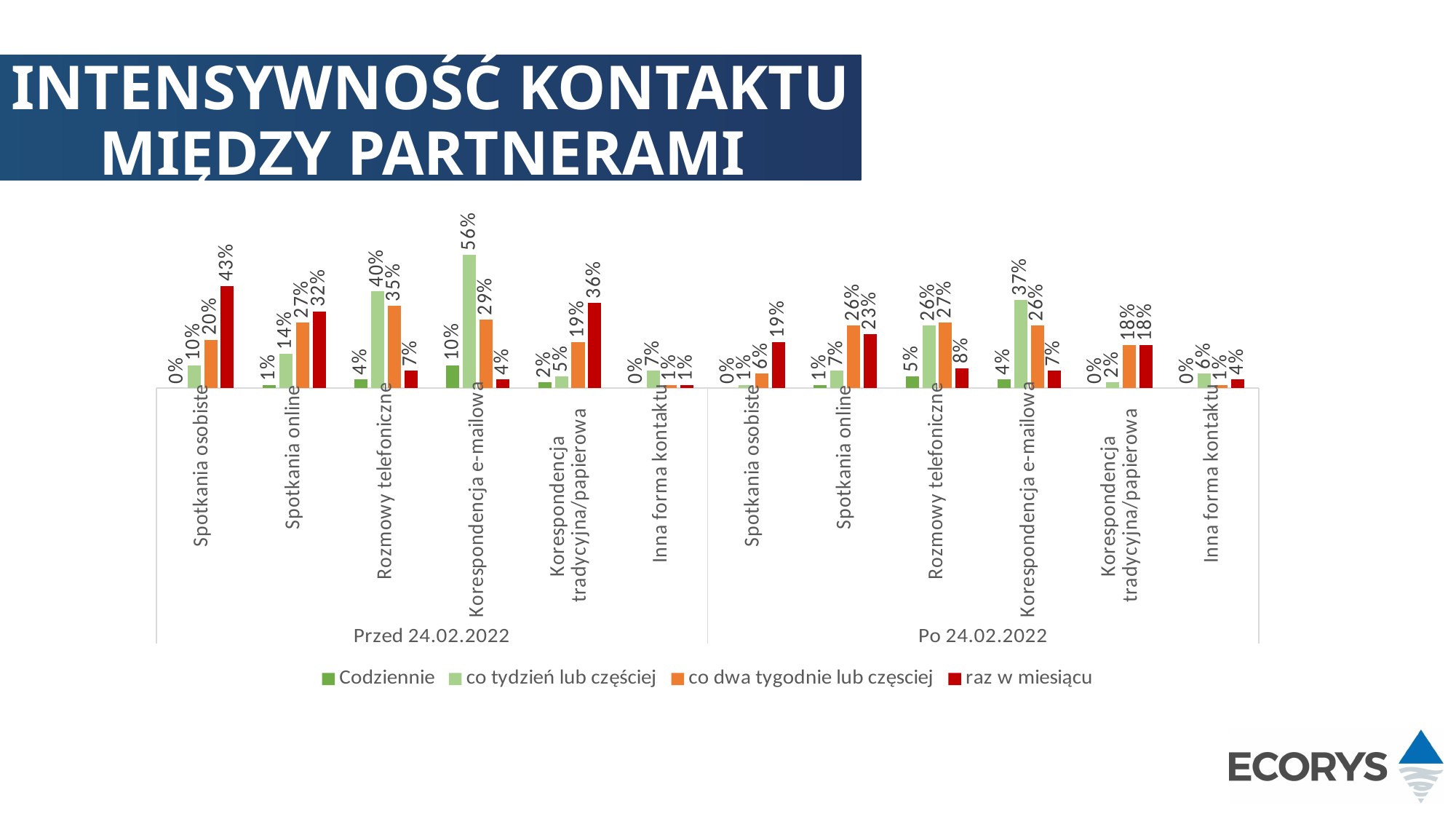
Which is larger: the 'raz w miesiącu' value for 'Spotkania osobiste' in the 'Przed 24.02.2022' group or in the 'Po 24.02.2022' group? Przed 24.02.2022 How many categories are shown in the 'Po 24.02.2022' group? 6 Which category has the lowest 'raz w miesiącu' value in the 'Po 24.02.2022' group? Inna forma kontaktu What is the value for 'co dwa tygodnie lub częsciej' for 'Rozmowy telefoniczne' in the 'Przed 24.02.2022' group? 35% What kind of chart is shown on the slide? bar chart What is the title of the slide? INTENSYWNOŚĆ KONTAKTU MIĘDZY PARTNERAMI What is the value for 'Codziennie' for 'Korespondencja e-mailowa' in the 'Przed 24.02.2022' group? 10% Which category has the highest 'co tydzień lub częściej' value in the 'Przed 24.02.2022' group? Korespondencja e-mailowa What is the difference between the 'co tydzień lub częściej' value for 'Korespondencja e-mailowa' before 24.02.2022 (56%) and after 24.02.2022 (37%)? 19% What is the value for 'raz w miesiącu' for 'Spotkania osobiste' in the 'Przed 24.02.2022' group? 43% What is the value for 'co tydzień lub częściej' for 'Korespondencja e-mailowa' in the 'Po 24.02.2022' group? 37% How many series does the legend list? 4